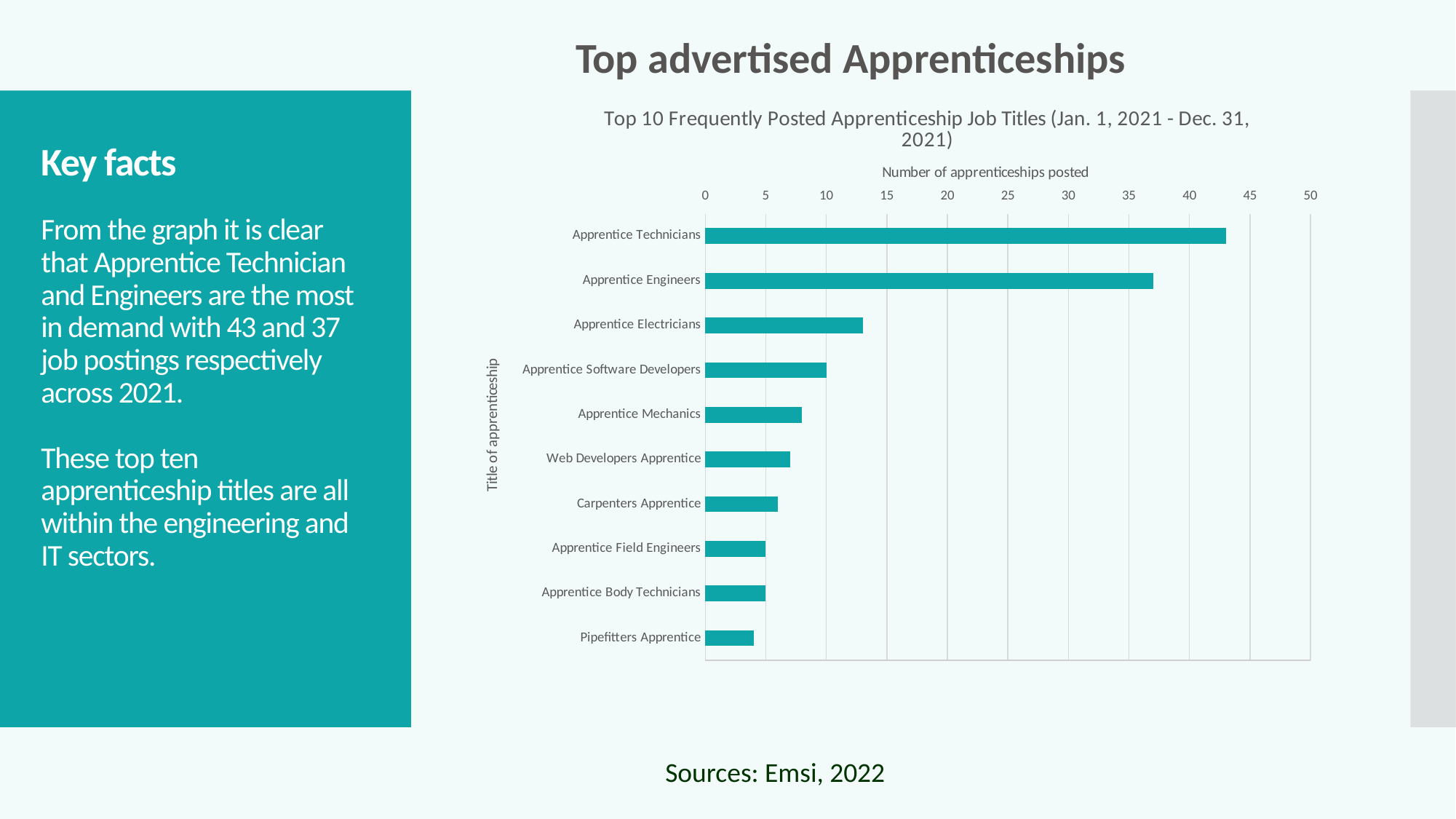
Which apprenticeship title has the highest number of apprenticeships posted? Apprentice Technicians Is the value for Pipefitters Apprentice greater or less than 5? less What kind of chart is shown on the slide? bar chart How many apprenticeships were posted for Apprentice Technicians? 43 What is the difference between the number of postings for Apprentice Technicians and Apprentice Engineers? 6 How many apprenticeships were posted for Apprentice Engineers? 37 What is the title of the horizontal axis of the chart? Number of apprenticeships posted Which apprenticeship title has the lowest number of apprenticeships posted? Pipefitters Apprentice How many apprenticeship job titles are plotted in the chart? 10 How many apprenticeships were posted for Apprentice Software Developers? 10 Is the value for Apprentice Electricians greater or less than 10? greater Which has more apprenticeships posted, Apprentice Electricians or Apprentice Mechanics? Apprentice Electricians